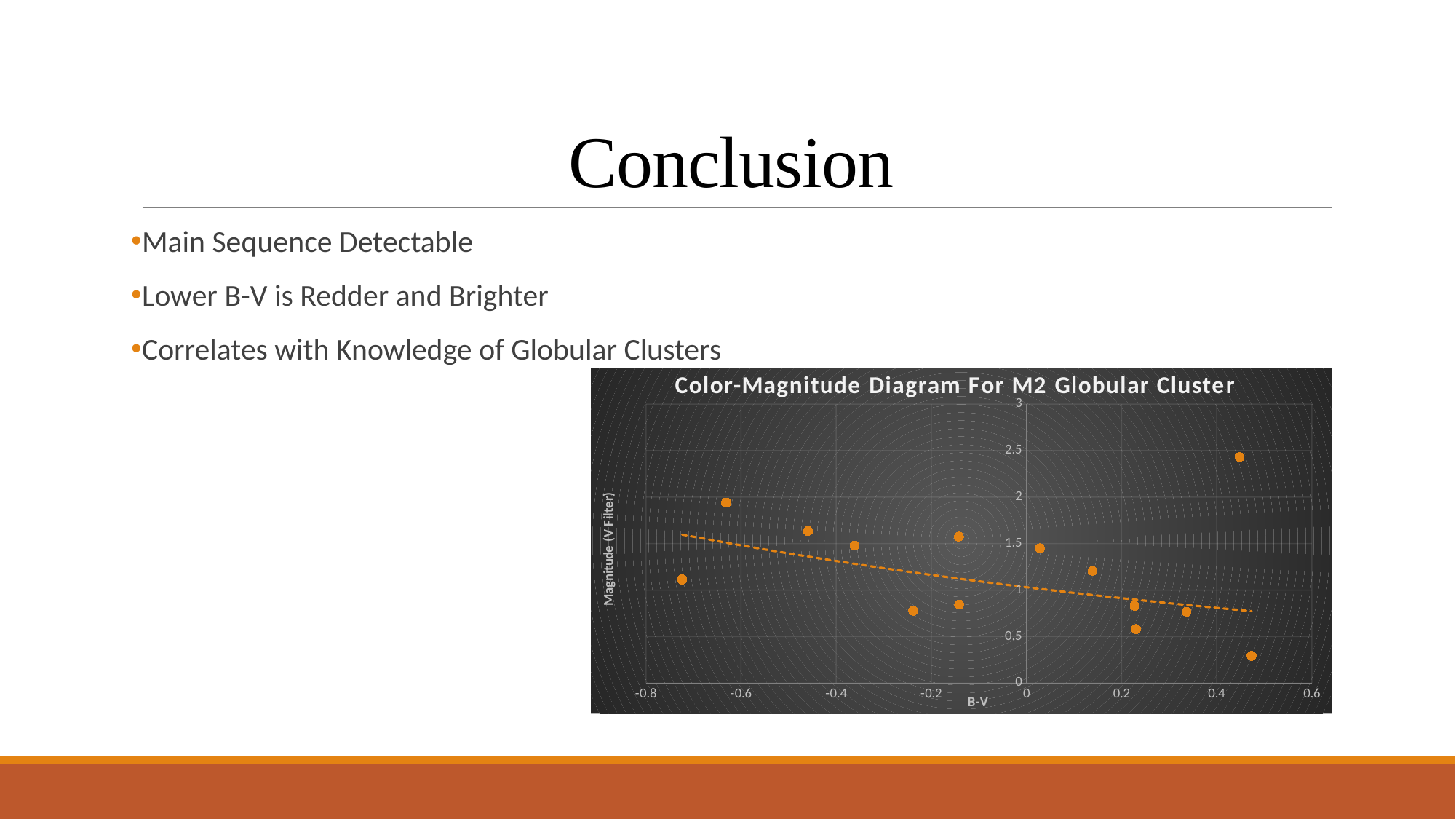
Is the magnitude of the point near B-V -0.63 greater or less than 1.5? greater Is the magnitude of the lowest point, near B-V 0.47, greater or less than 0.5? less What is the maximum value shown on the y axis of the chart? 3 What type of chart is shown on the slide? Scatter chart According to the dashed trend line, do magnitude values rise or fall as B-V increases? Fall How many data points are plotted on the chart? 14 What is the label of the x axis of the chart? B-V Which has the higher magnitude: the point near B-V 0.45 or the point near B-V 0.47? The point near B-V 0.45 Is the magnitude of the point near B-V -0.72 greater or less than 1.5? less What is the title of the chart? Color-Magnitude Diagram For M2 Globular Cluster Which has the higher magnitude: the point near B-V -0.63 or the point near B-V -0.72? The point near B-V -0.63